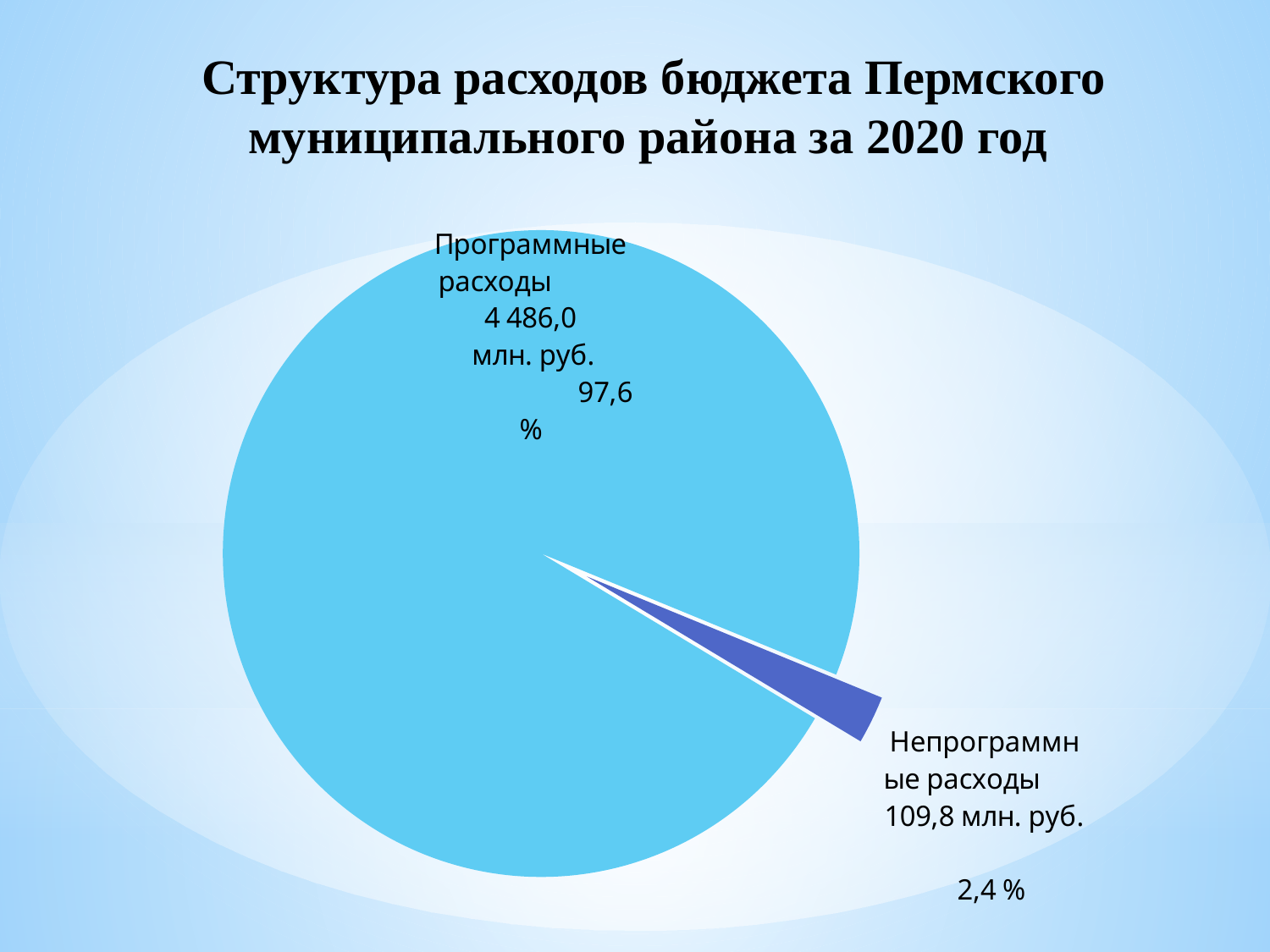
Which category has the smallest slice of the pie? Непрограммные расходы What kind of chart is shown on the slide? pie chart Which category has the largest slice of the pie? Программные расходы What is the value for Программные расходы in млн. руб.? 4 486,0 млн. руб. What colour is the slice for Непрограммные расходы? dark blue Which is larger, Программные расходы or Непрограммные расходы? Программные расходы What is the difference in млн. руб. between Программные расходы and Непрограммные расходы? 4 376,2 млн. руб. What share of the pie does Непрограммные расходы take? 2,4 % How many slices does the pie chart have? 2 What is the title of the slide containing the chart? Структура расходов бюджета Пермского муниципального района за 2020 год What is the value for Непрограммные расходы in млн. руб.? 109,8 млн. руб. What share of the pie does Программные расходы take? 97,6 %